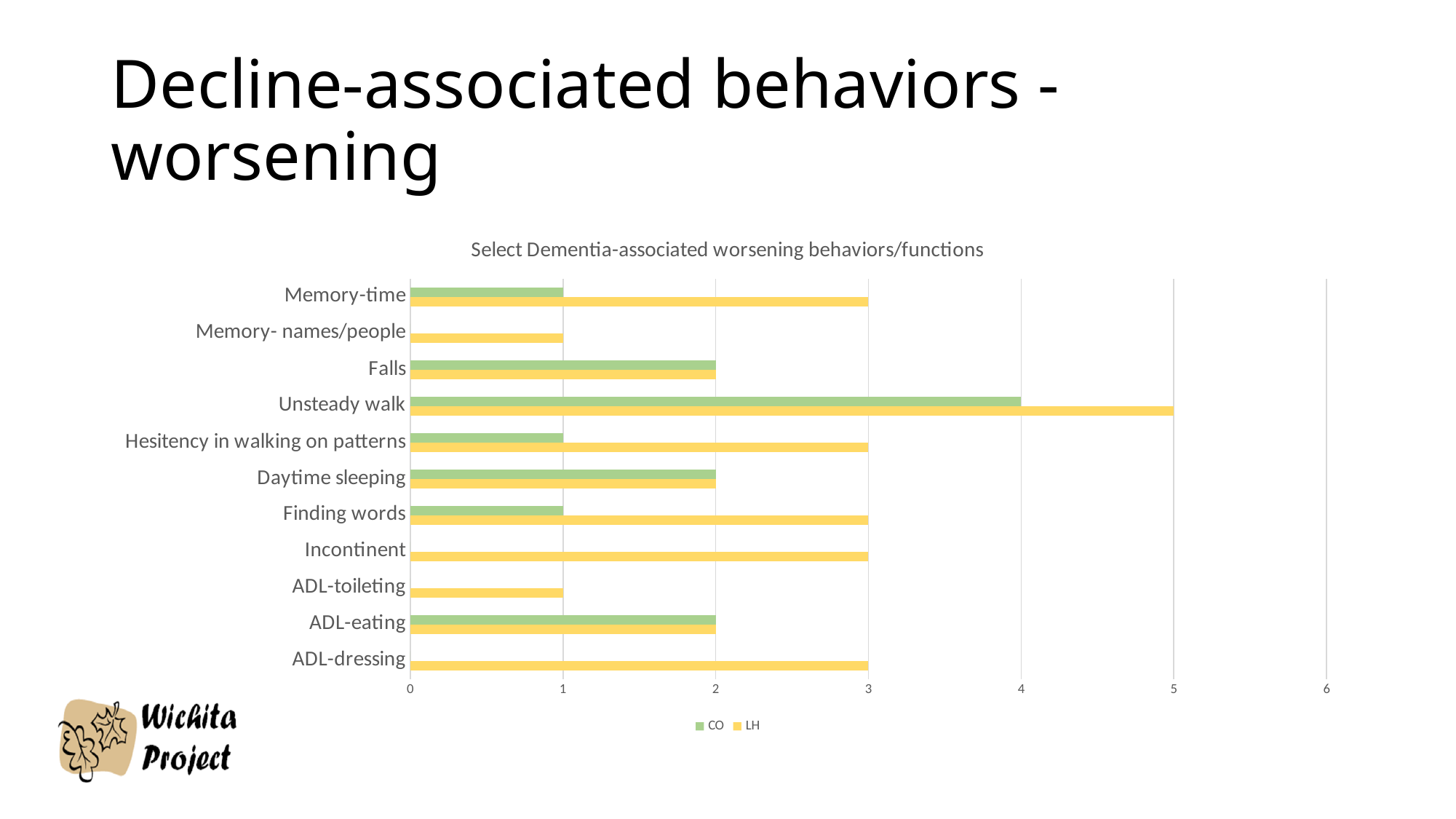
How many series does the legend list? 2 What is the difference between the LH and CO values for Unsteady walk? 1 Which category has the highest LH value? Unsteady walk What is the LH value for Unsteady walk? 5 Which is larger for Hesitency in walking on patterns, the CO value or the LH value? LH Which category has the highest CO value? Unsteady walk What is the LH value for Memory-time? 3 What is the CO value for Falls? 2 What type of chart is shown on the slide? Bar chart What is the CO value for Unsteady walk? 4 What is the difference between the LH and CO values for Finding words? 2 How many categories are shown on the chart? 11